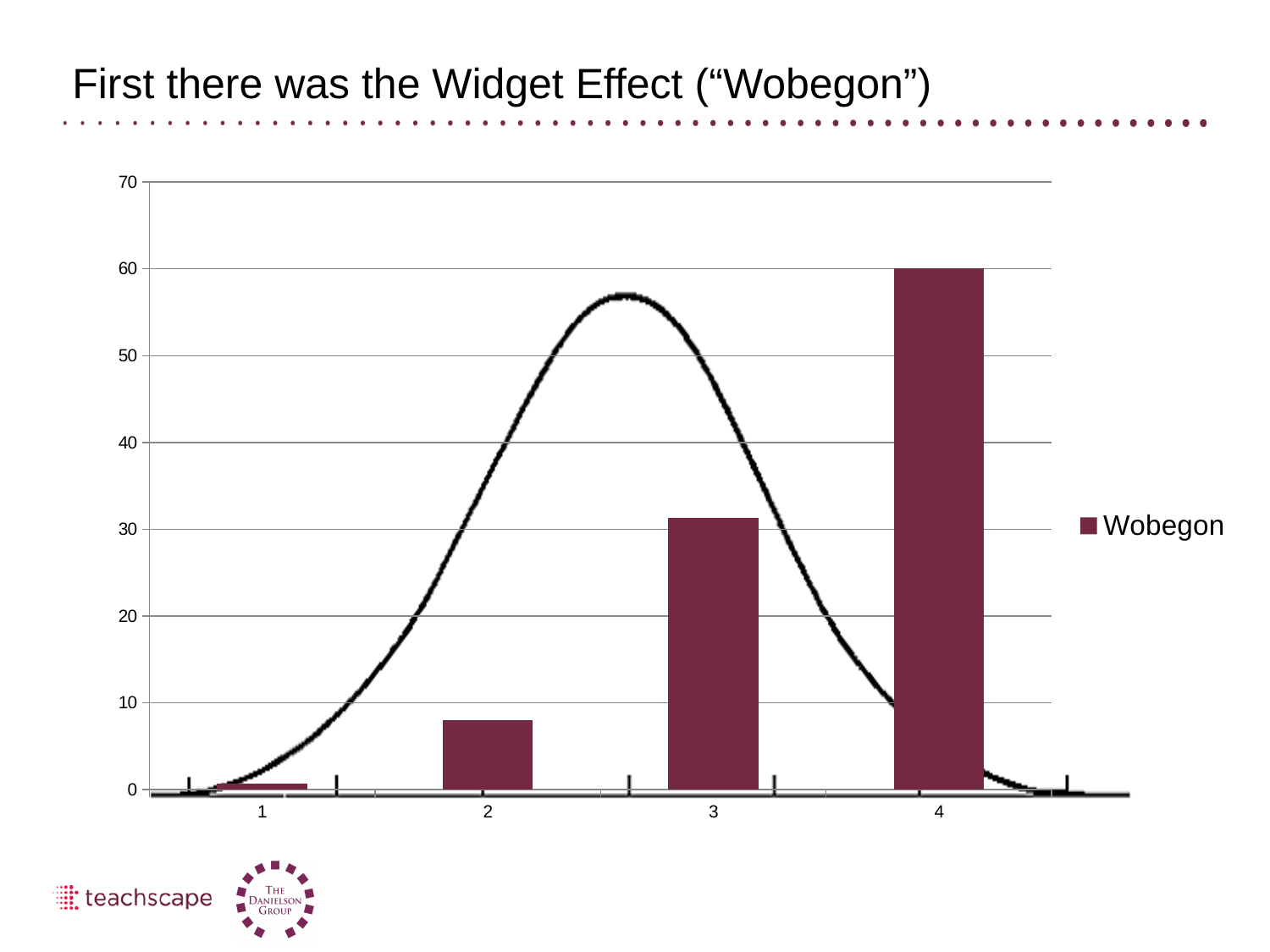
What kind of chart is shown on the slide? bar chart Which category has the lowest Wobegon value? 1 What is the name of the series shown in the legend? Wobegon Is the Wobegon value for category 3 greater or less than 40? less Which has a larger Wobegon value, category 2 or category 3? 3 Do the Wobegon values rise or fall from category 1 to category 4? rise Is the Wobegon value for category 3 greater or less than 20? greater Is the Wobegon value for category 2 greater or less than 10? less How many categories are shown on the x axis? 4 How many series does the legend list? 1 Which category has the highest Wobegon value? 4